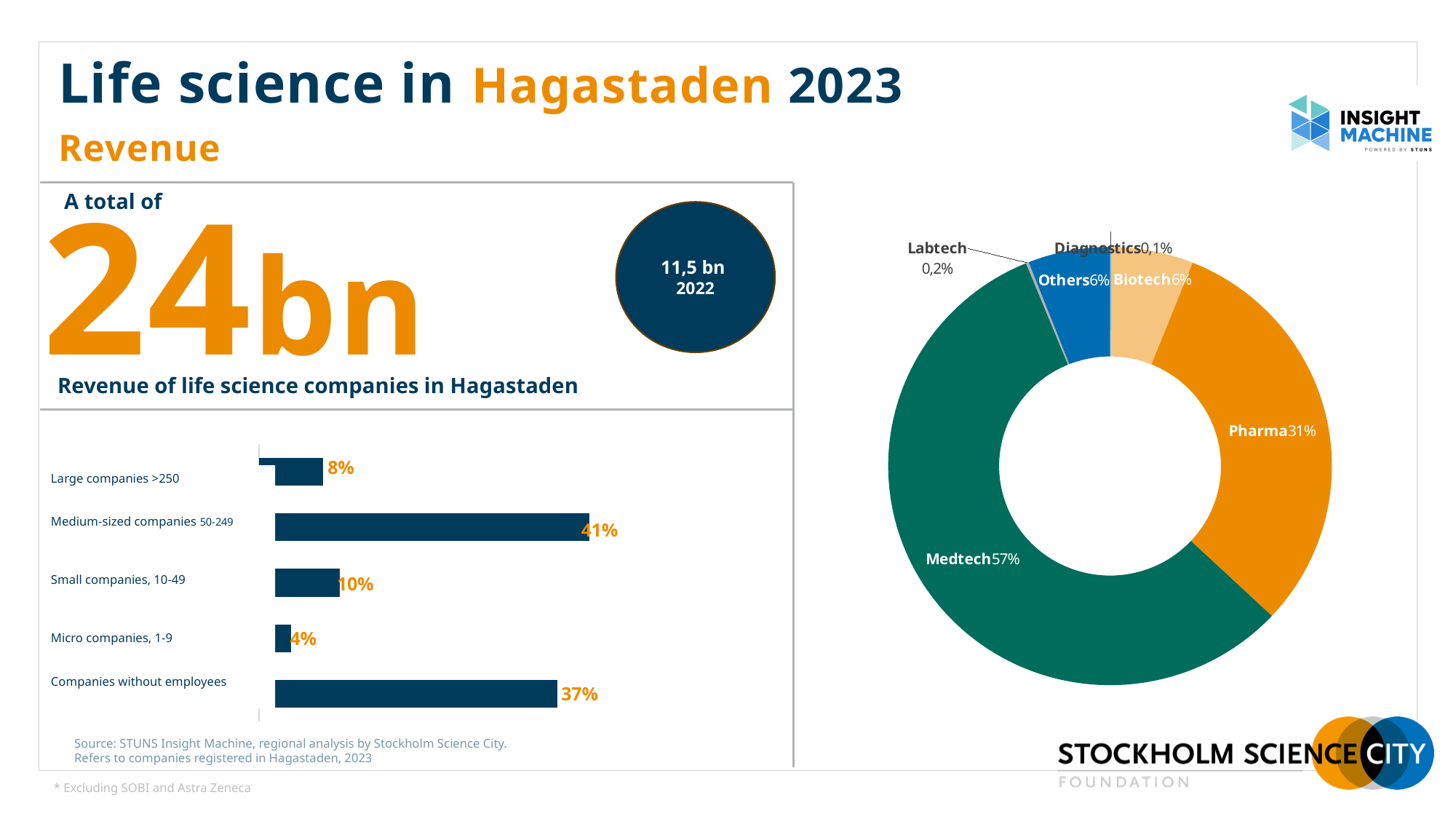
How many categories does the bar chart on the left show? 5 In the donut chart on the right, what is the difference between Medtech and Pharma? 26% In the bar chart on the left, which category has the lowest value? Micro companies, 1-9 In the donut chart on the right, which sector has the smallest share? Diagnostics In the bar chart on the left, which is larger: large companies >250 or small companies, 10-49? Small companies, 10-49 In the donut chart on the right, what share does Medtech have? 57% In the donut chart on the right, what is the value for Labtech? 0,2% In the bar chart on the left, what is the value for micro companies, 1-9? 4% In the bar chart on the left, what share of revenue comes from medium-sized companies (50-249)? 41% What kind of chart is the chart on the left of the slide? Bar chart In the bar chart on the left, which category has the highest value? Medium-sized companies 50-249 In the bar chart on the left, what is the difference between medium-sized companies and companies without employees? 4%